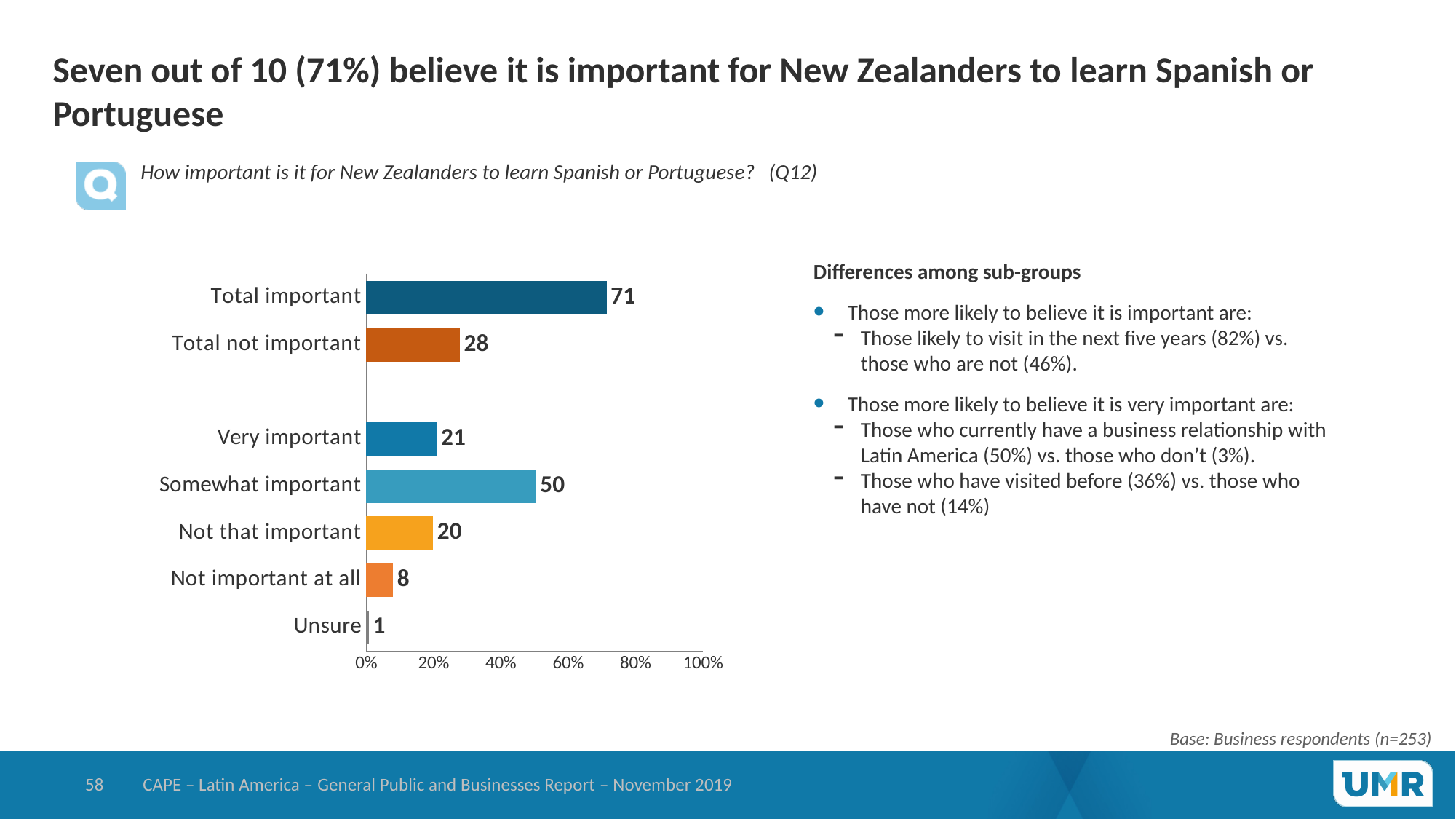
How many categories are shown on the chart? 7 Is the value for Somewhat important greater or less than 40%? greater What is the maximum value shown on the x axis? 100% What is the difference between Total important and Total not important? 43 Which category has the lowest value? Unsure What is the value for Not important at all? 8 What is the value for Somewhat important? 50 Which category has the highest value? Total important What is the value for Total important? 71 Which is larger, Very important or Not that important? Very important What is the value for Unsure? 1 What kind of chart is shown? Bar chart